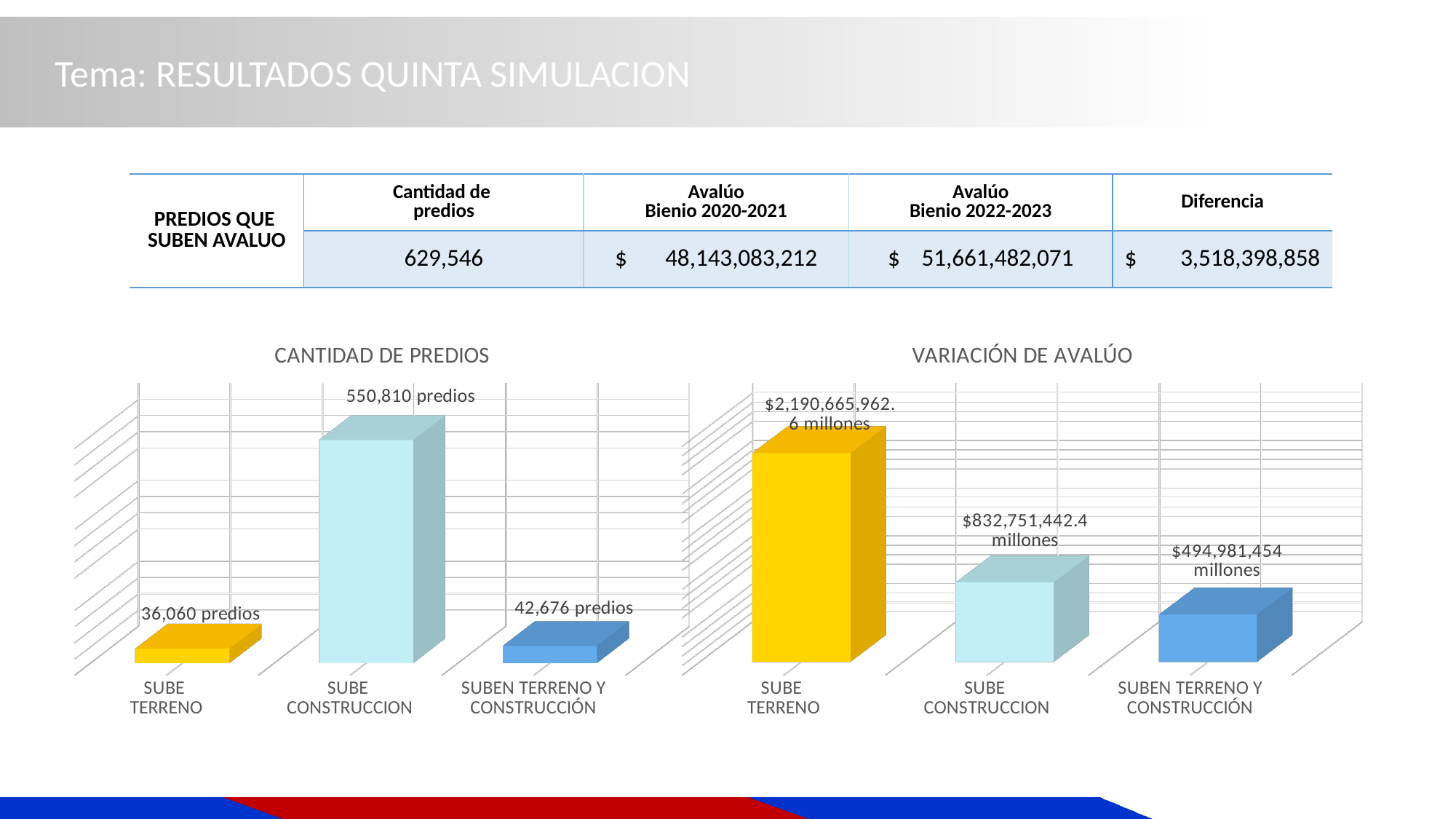
In the VARIACIÓN DE AVALÚO chart, what is the value for SUBEN TERRENO Y CONSTRUCCIÓN? $494,981,454 millones What kind of chart is the VARIACIÓN DE AVALÚO chart? bar chart In the CANTIDAD DE PREDIOS chart, what is the value for SUBE TERRENO? 36,060 predios In the CANTIDAD DE PREDIOS chart, which category has the highest value? SUBE CONSTRUCCION In the CANTIDAD DE PREDIOS chart, what is the value for SUBE CONSTRUCCION? 550,810 predios In the VARIACIÓN DE AVALÚO chart, do the values rise or fall from left to right across the categories? fall In the CANTIDAD DE PREDIOS chart, which category has the lowest value? SUBE TERRENO In the CANTIDAD DE PREDIOS chart, what is the difference between SUBE CONSTRUCCION and SUBEN TERRENO Y CONSTRUCCIÓN? 508,134 predios In the VARIACIÓN DE AVALÚO chart, what is the value for SUBE TERRENO? $2,190,665,962.6 millones In the VARIACIÓN DE AVALÚO chart, which is larger, SUBE TERRENO or SUBE CONSTRUCCION? SUBE TERRENO In the VARIACIÓN DE AVALÚO chart, which category has the lowest value? SUBEN TERRENO Y CONSTRUCCIÓN In the CANTIDAD DE PREDIOS chart, how many categories are shown? 3